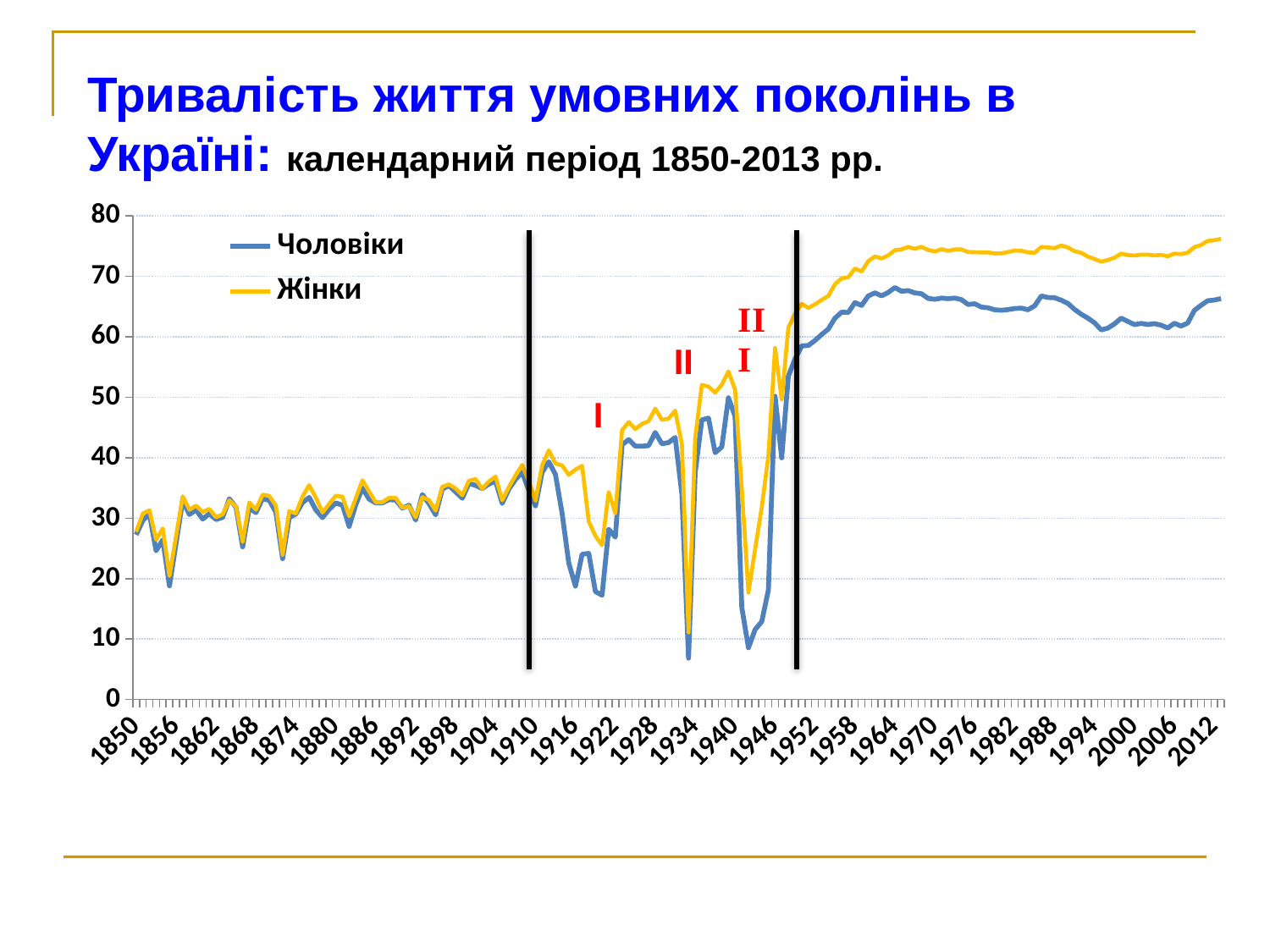
Is the value for Жінки in 2012 greater or less than 70? greater Is the value for Жінки in 1910 greater or less than 50? less How many series does the legend list? 2 What is the title of the chart on the slide? Тривалість життя умовних поколінь в Україні: календарний період 1850-2013 рр. What kind of chart is shown on the slide? line chart What are the two series named in the legend? Чоловіки and Жінки Is the value for Чоловіки in 2012 greater or less than 70? less Between 1952 and 1964, does the Жінки line rise or fall? rise Which series reaches the highest value anywhere on the chart? Жінки In 2012, which series has the higher value, Чоловіки or Жінки? Жінки How many year labels are shown on the x axis? 28